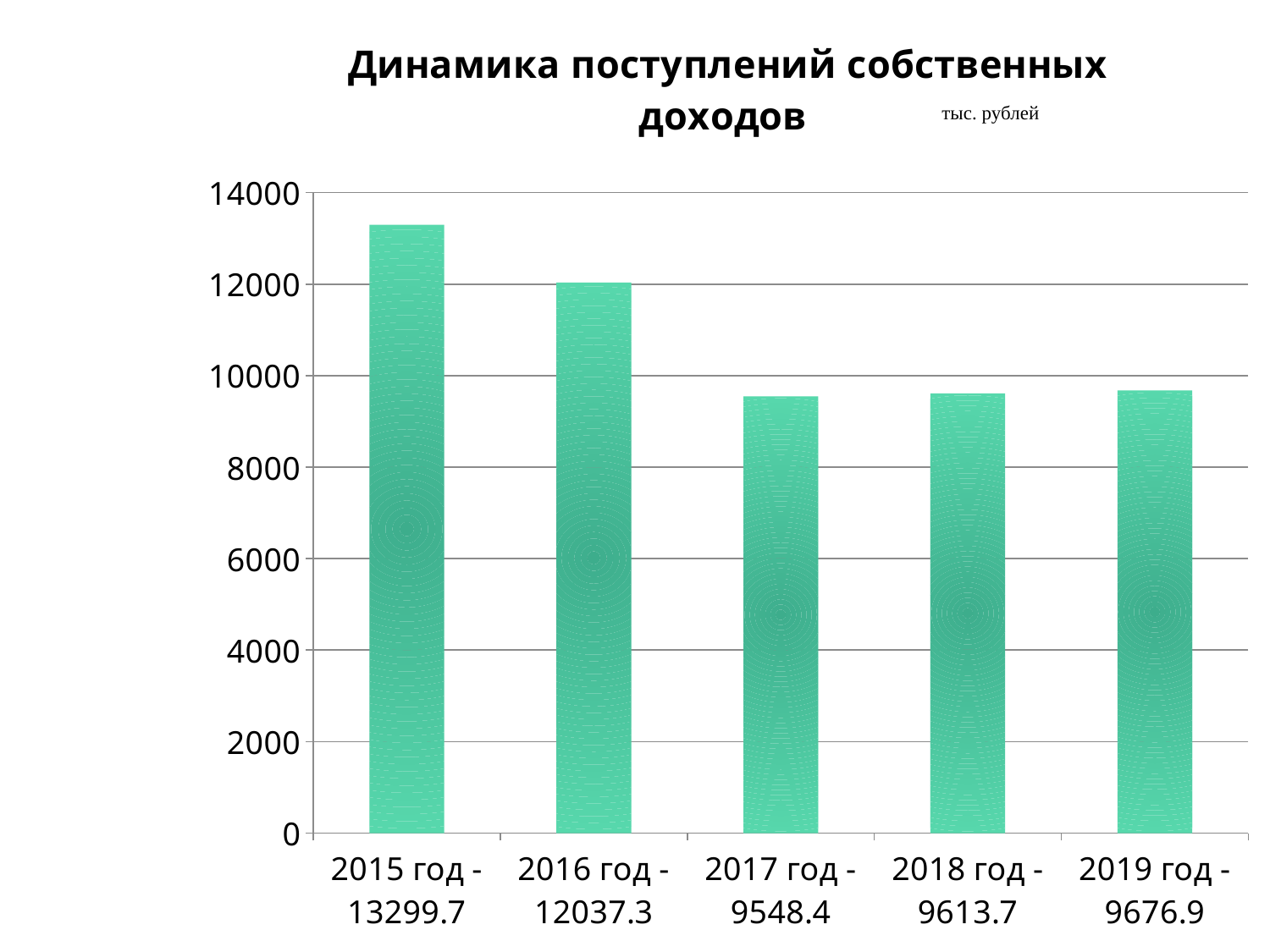
What kind of chart is this? bar chart Do the values rise or fall from 2015 год to 2017 год? fall What is the value for 2015 год? 13299.7 What is the value for 2019 год? 9676.9 What is the value for 2017 год? 9548.4 How many years are shown on the chart? 5 What is the difference between the values for 2015 год and 2016 год? 1262.4 Which is larger, the value for 2018 год or 2019 год? 2019 год Which year has the lowest value? 2017 год Is the value for 2017 год greater or less than 10000? less Which year has the highest value? 2015 год What is the difference between the values for 2019 год and 2017 год? 128.5